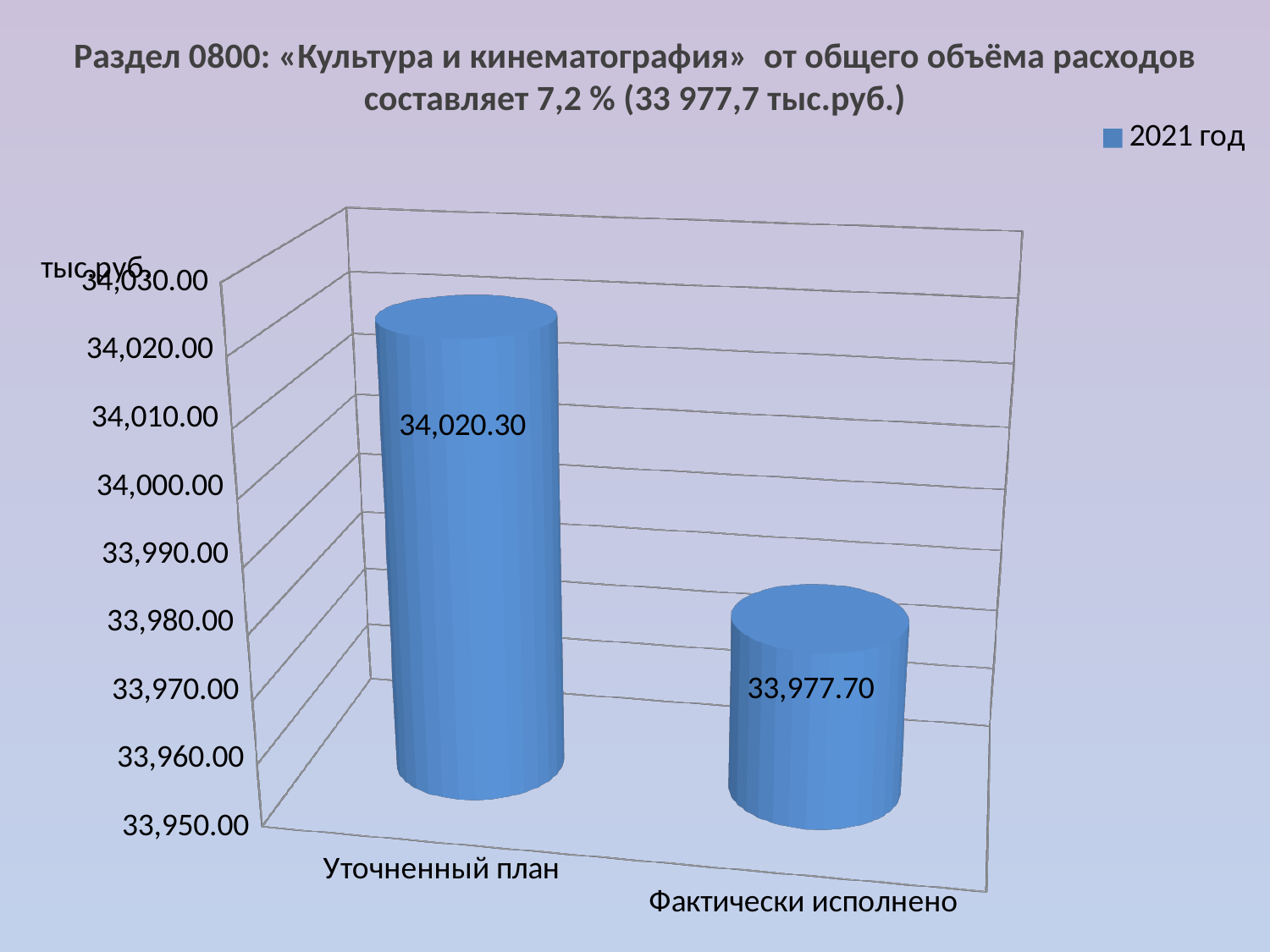
What is the difference between the values for «Уточненный план» and «Фактически исполнено»? 42.60 Is the value for «Уточненный план» greater or less than 34,000.00? greater Which category has the lowest value? Фактически исполнено Which category has the highest value? Уточненный план How many series does the legend list? 1 Is the value for «Фактически исполнено» greater or less than 34,000.00? less What is the value for «Фактически исполнено»? 33,977.70 Which is larger: the value for «Уточненный план» or for «Фактически исполнено»? Уточненный план How many categories are shown on the chart? 2 What series name is shown in the legend? 2021 год What is the value for «Уточненный план»? 34,020.30 What kind of chart is shown on the slide? bar chart